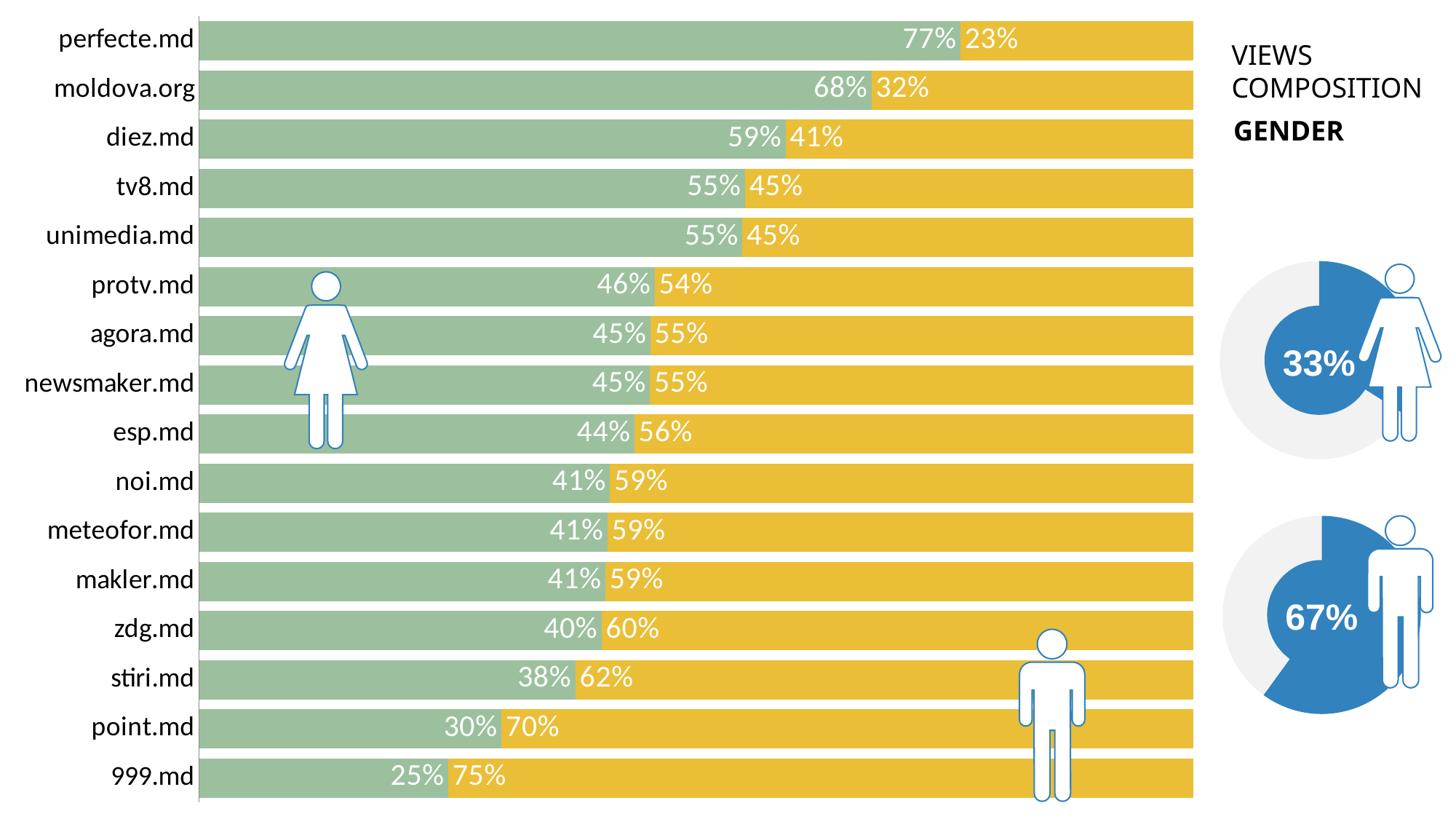
Which has a larger green segment, tv8.md or protv.md? tv8.md Do the green segments increase or decrease going from the top bar to the bottom bar? Decrease How many websites are listed in the bar chart? 16 What is the value of the green segment for perfecte.md? 77% What percentage is shown in the circle next to the male figure on the right of the slide? 67% What is the value of the yellow segment for 999.md? 75% Which website has the largest green segment? perfecte.md What kind of chart is used to show the per-website values? Stacked bar chart What do the green and yellow segments for stiri.md add up to? 100% Which website has the smallest green segment? 999.md What is the difference between the green and yellow segments for moldova.org? 36% What is the value of the yellow segment for diez.md? 41%